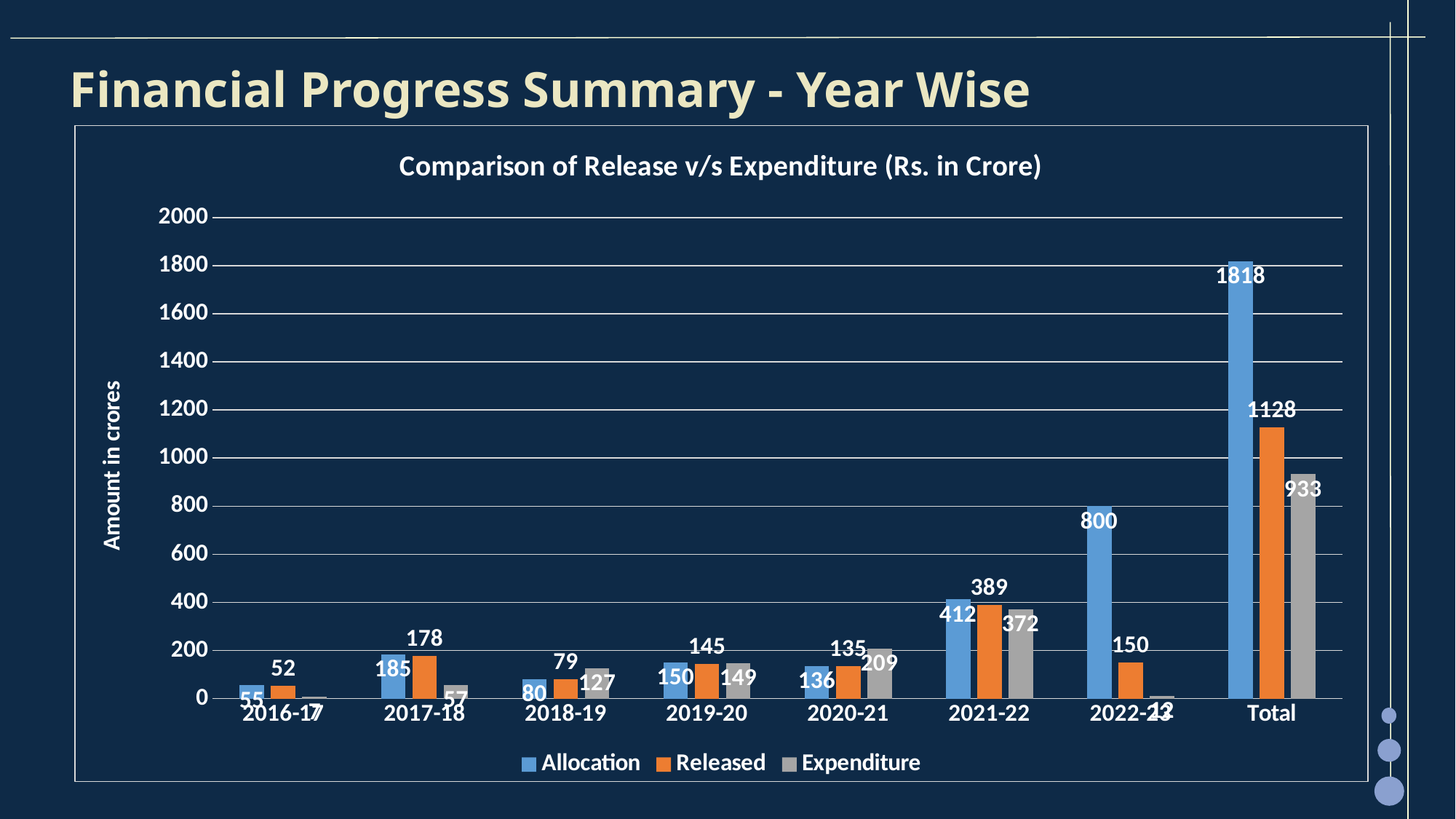
How many categories are shown on the x axis? 8 What is the Allocation value for the Total category? 1818 What is the Released value for 2021-22? 389 What kind of chart is shown on the slide? bar chart In 2018-19, which is larger: Allocation or Expenditure? Expenditure For 2021-22, what is the difference between Allocation and Expenditure? 40 Which year has the lowest Released value? 2016-17 Is the Allocation value for 2022-23 greater or less than 600? greater Excluding the Total category, which year has the highest Allocation? 2022-23 How many series does the legend list? 3 For the Total category, what is the difference between Allocation and Released? 690 What is the Expenditure value for 2020-21? 209